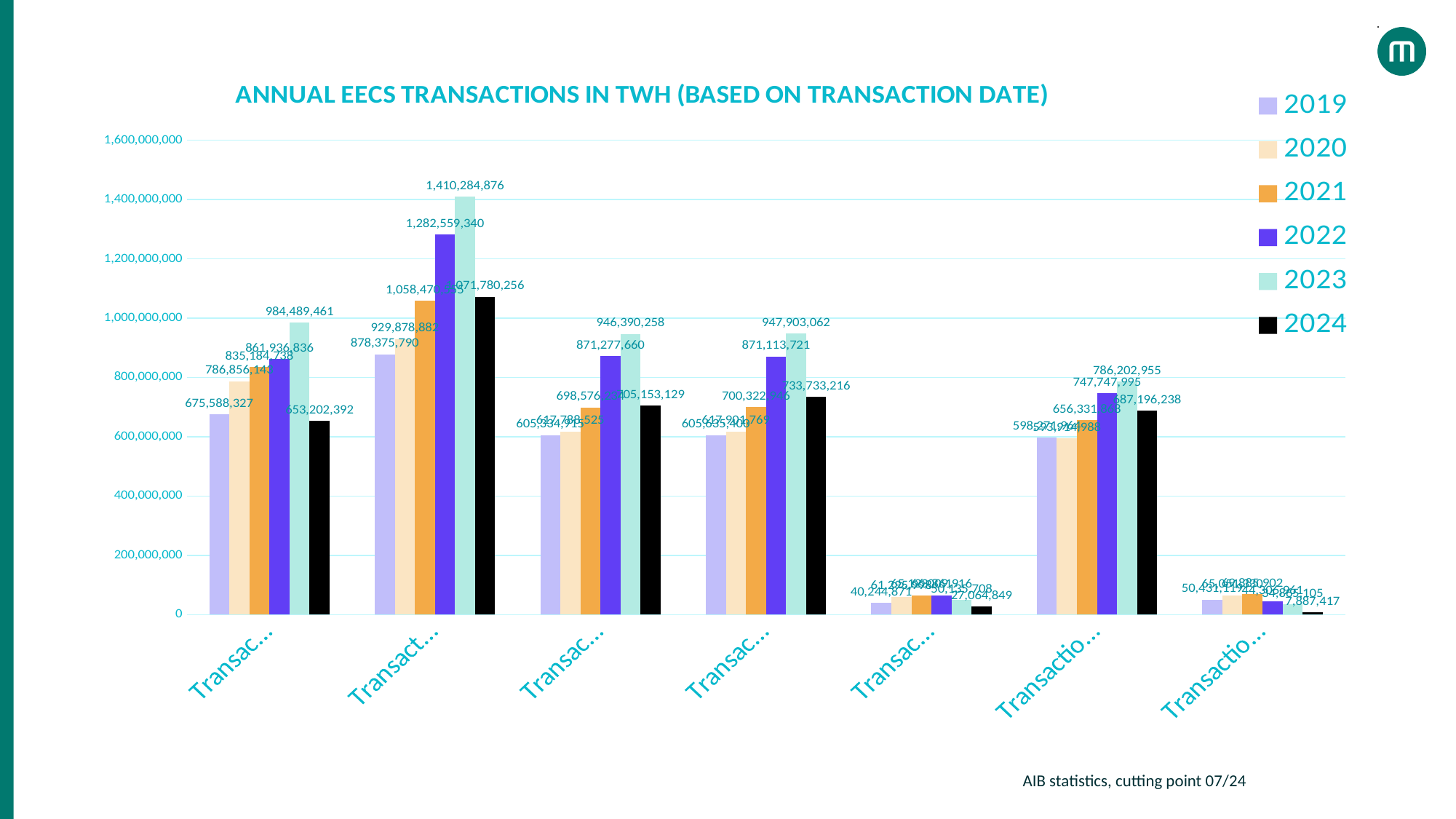
How many category groups are plotted along the x axis? 7 What is the value of the 2024 bar in the seventh (rightmost) category group? 7,887,417 What is the value of the 2023 bar in the second category group from the left? 1,410,284,876 How many series does the legend list? 6 In the fourth category group from the left, is the 2023 bar or the 2024 bar larger? 2023 What is the difference between the 2023 bar (1,410,284,876) and the 2022 bar (1,282,559,340) in the second category group? 127,725,536 What is the title of the chart? ANNUAL EECS TRANSACTIONS IN TWH (BASED ON TRANSACTION DATE) Which year has the lowest bar in the first (leftmost) category group? 2024 What is the value of the 2022 bar in the second category group from the left? 1,282,559,340 What is the value of the 2019 bar in the first (leftmost) category group? 675,588,327 Which year has the highest bar in the second category group from the left? 2023 What type of chart is shown on the slide? bar chart